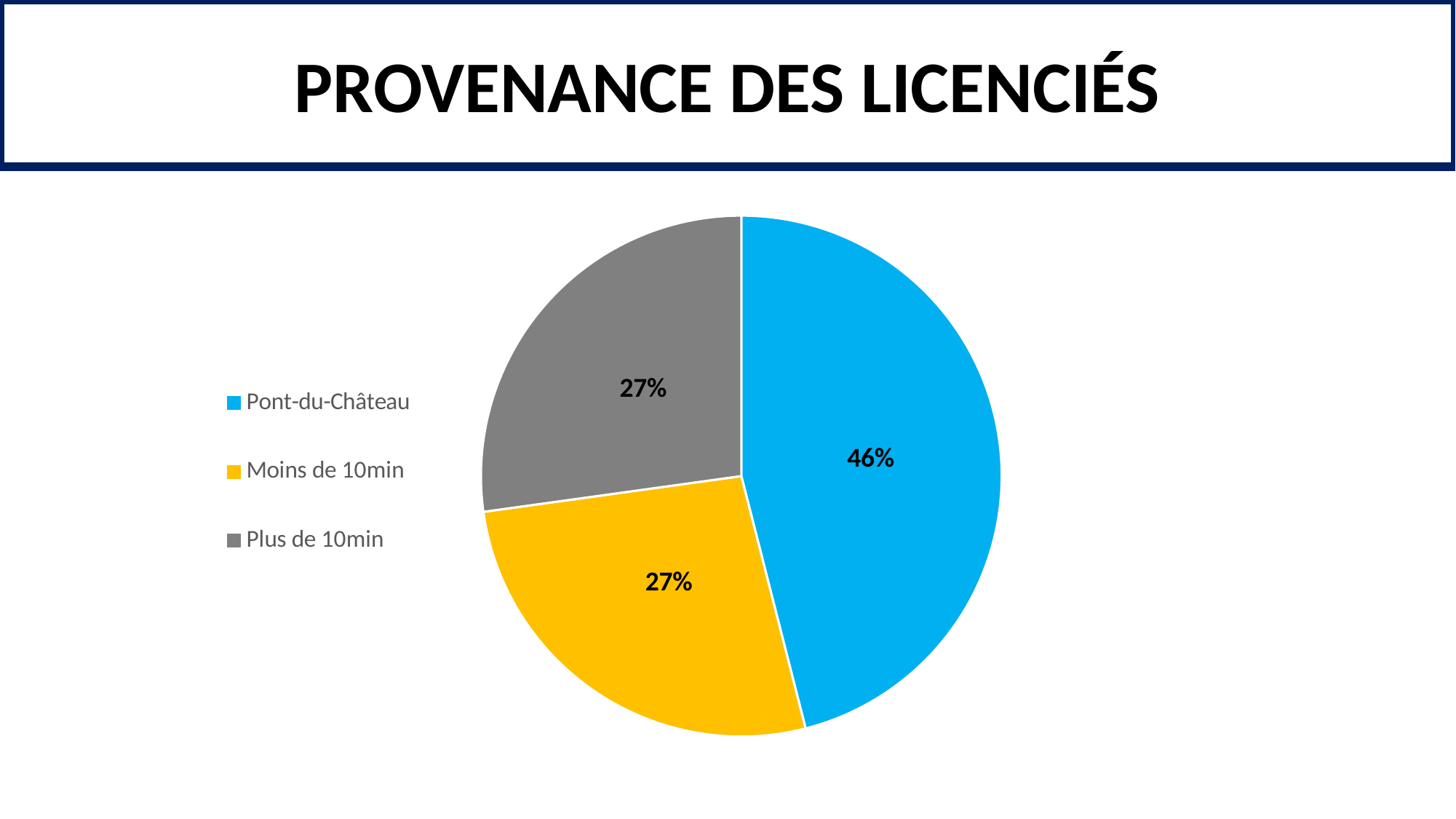
Which category has the largest slice of the pie? Pont-du-Château What colour is the slice for Moins de 10min? yellow What is the difference in percentage points between Pont-du-Château and Moins de 10min? 19 What kind of chart is shown on the slide? pie chart How many entries does the legend list? 3 How many slices does the pie chart have? 3 Which is larger, the slice for Pont-du-Château or the slice for Plus de 10min? Pont-du-Château What share of the pie does Moins de 10min represent? 27% What is the title of the slide containing the chart? PROVENANCE DES LICENCIÉS What share of the pie does Pont-du-Château represent? 46% What share of the pie does Plus de 10min represent? 27% What is the combined share of Moins de 10min and Plus de 10min? 54%